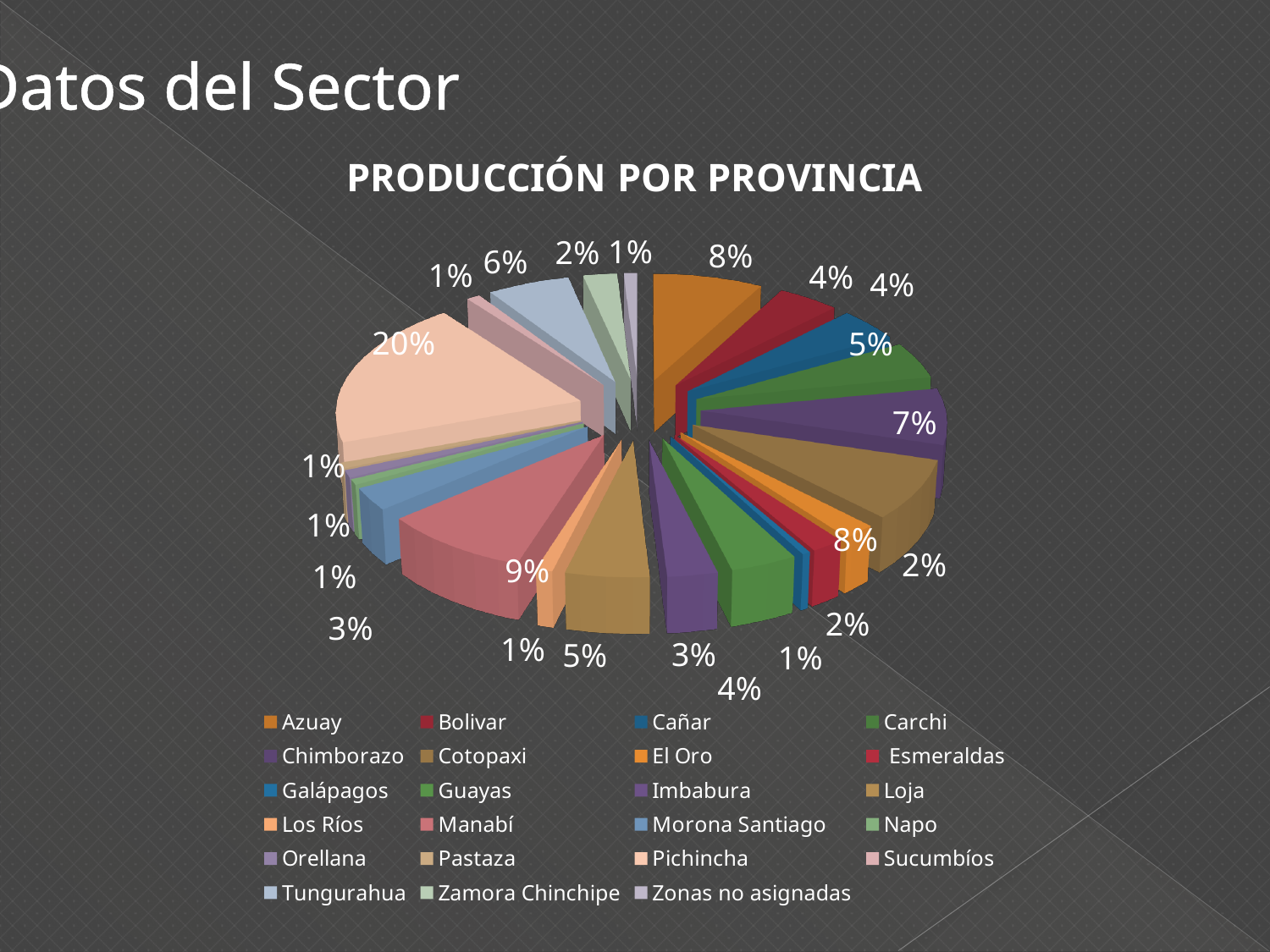
By how many percentage points does Pichincha's share exceed Manabí's? 11 What is the title of the chart? PRODUCCIÓN POR PROVINCIA What percentage is shown for Manabí? 9% What share of production does Pichincha account for? 20% What type of chart is shown on the slide? pie chart What percentage is shown for Chimborazo? 7% Which has a larger share, Pichincha or Manabí? Pichincha Which province has the largest share of production? Pichincha How many provinces (categories) does the legend list? 23 What percentage is shown for Azuay? 8% Which has a larger share, Azuay or Tungurahua? Azuay What percentage is shown for Tungurahua? 6%